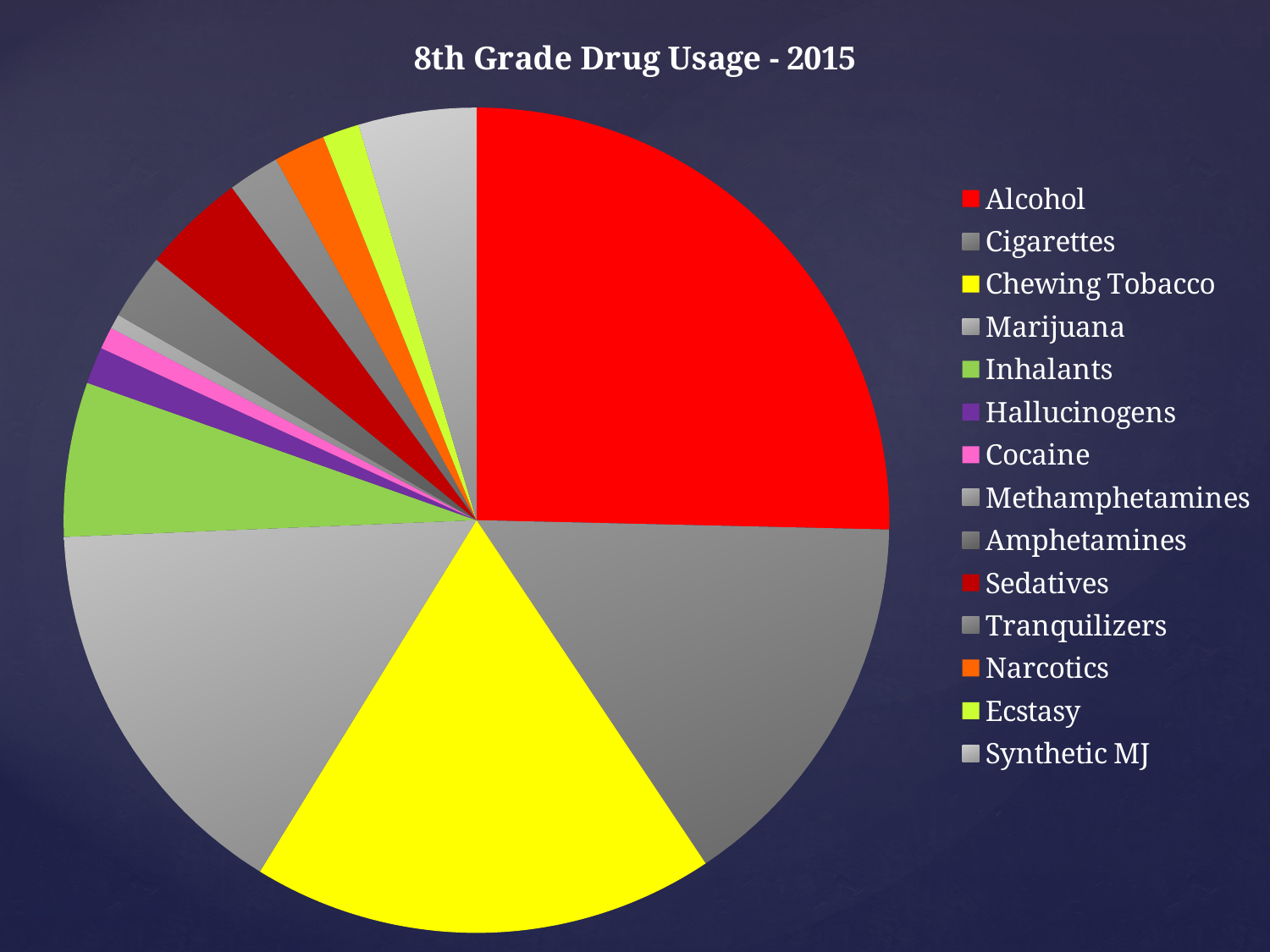
Which slice is larger, Alcohol or Marijuana? Alcohol Which slice is larger, Alcohol or Chewing Tobacco? Alcohol How many categories does the pie chart show? 14 What kind of chart is shown on the slide? pie chart Which slice is larger, Inhalants or Hallucinogens? Inhalants Which category is shown in yellow in the pie chart? Chewing Tobacco What is the title of the chart? 8th Grade Drug Usage - 2015 Which category has the largest slice of the pie? Alcohol